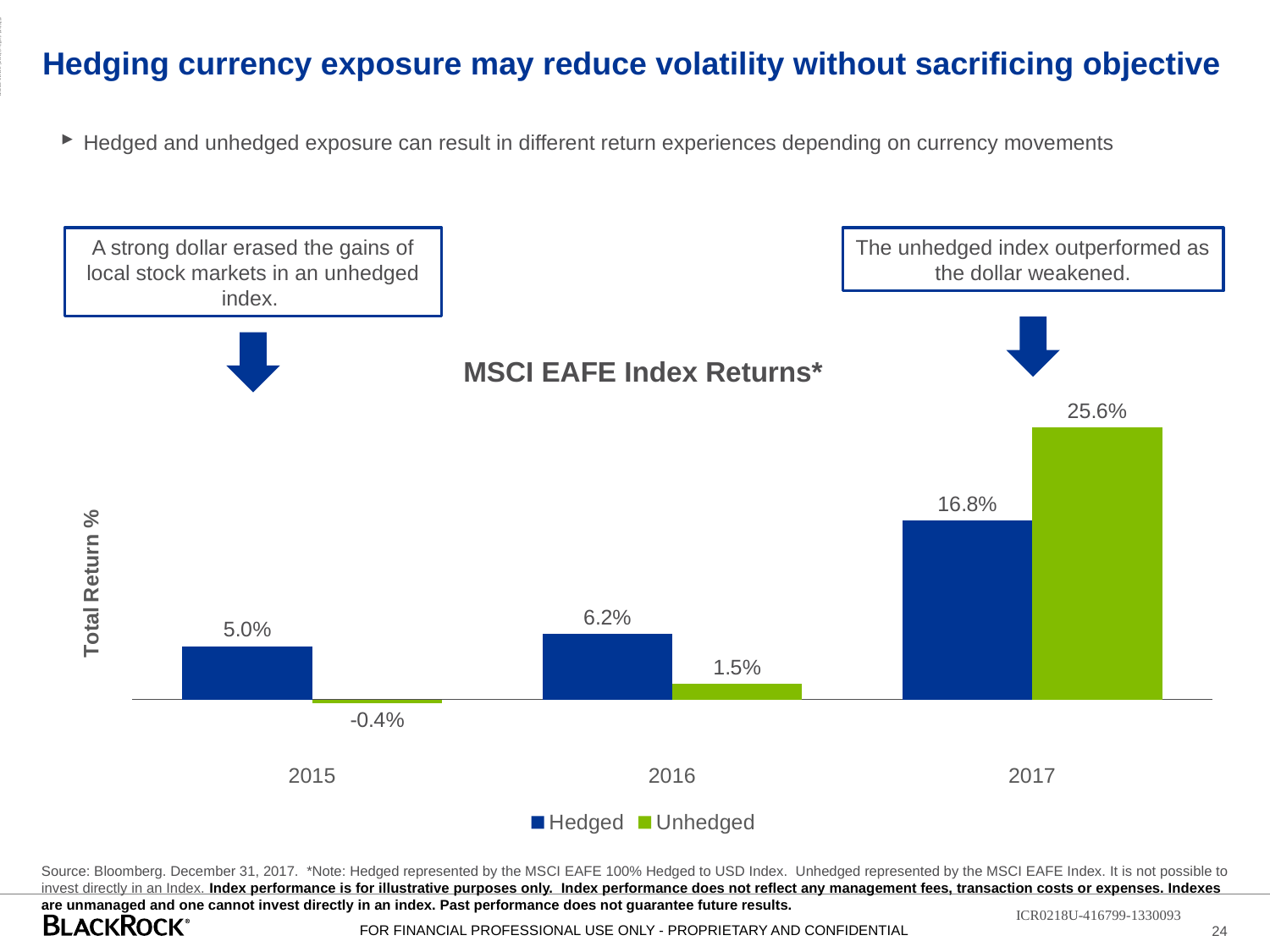
How many series does the legend list? 2 How many years are shown on the x axis? 3 In 2016, which is larger, the Hedged or the Unhedged return? Hedged What is the difference between the Unhedged and Hedged returns in 2017? 8.8% What kind of chart is shown? Bar chart What is the Unhedged return for 2015? -0.4% Which year has the lowest Hedged return? 2015 What is the Unhedged return for 2017? 25.6% What is the title of the chart? MSCI EAFE Index Returns* What is the Hedged return for 2016? 6.2% Which year has the highest Unhedged return? 2017 What is the Hedged return for 2015? 5.0%